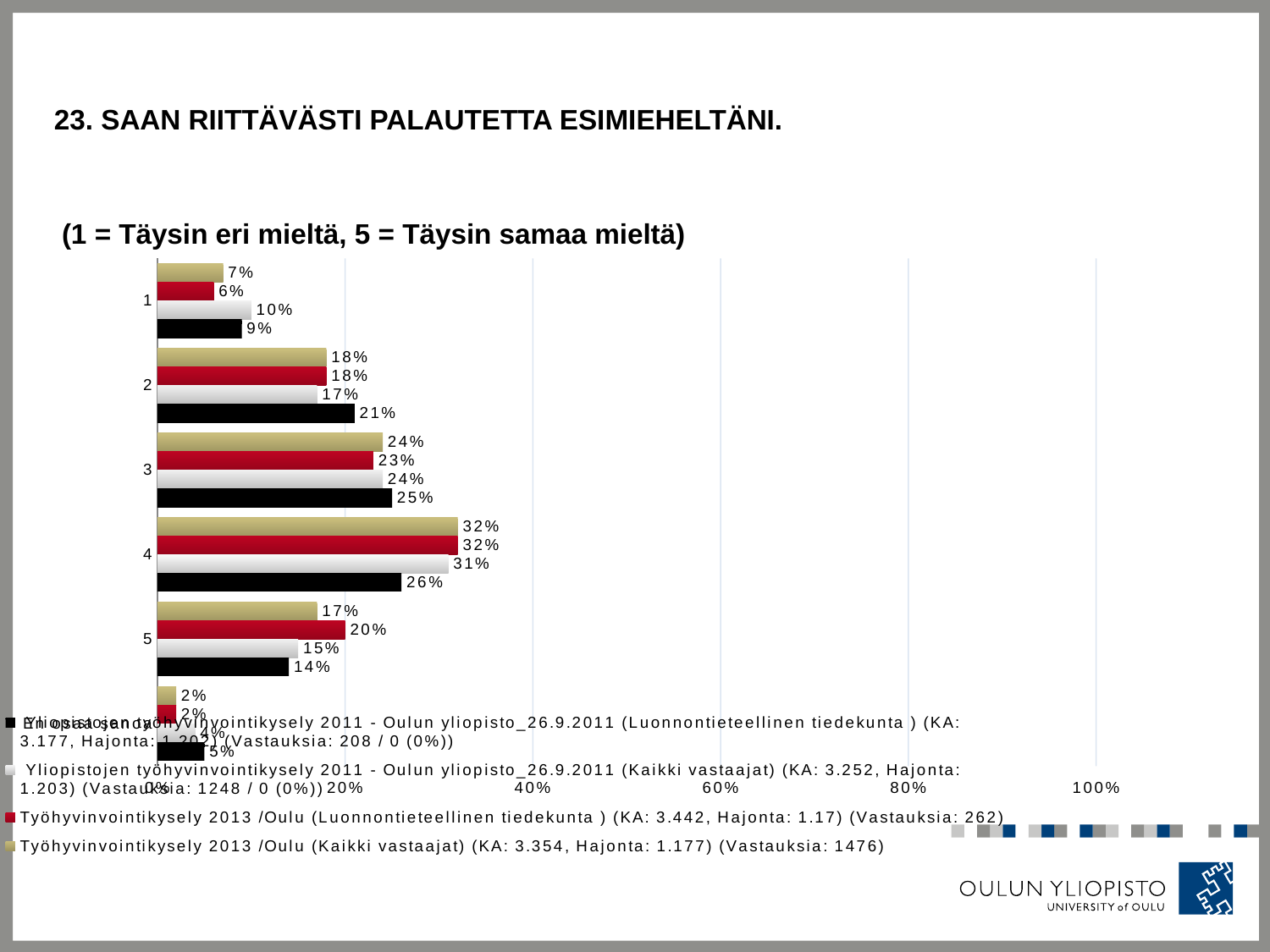
Which category has the highest value in the series Työhyvinvointikysely 2013 /Oulu (Kaikki vastaajat)? 4 What kind of chart is shown on the slide? Bar chart For category 5, which series has the larger value: Työhyvinvointikysely 2013 /Oulu (Luonnontieteellinen tiedekunta) or Yliopistojen työhyvinvointikysely 2011 - Oulun yliopisto (Luonnontieteellinen tiedekunta)? Työhyvinvointikysely 2013 /Oulu (Luonnontieteellinen tiedekunta) What is the value for category 5 in the series Työhyvinvointikysely 2013 /Oulu (Luonnontieteellinen tiedekunta)? 20% Which of categories 1 to 5 has the lowest value in the series Työhyvinvointikysely 2013 /Oulu (Luonnontieteellinen tiedekunta)? 1 What is the value for category 4 in the series Työhyvinvointikysely 2013 /Oulu (Kaikki vastaajat)? 32% What is the difference between the values for category 4 in the series Työhyvinvointikysely 2013 /Oulu (Kaikki vastaajat) and Yliopistojen työhyvinvointikysely 2011 - Oulun yliopisto (Luonnontieteellinen tiedekunta)? 6% What is the value for category 2 in the series Yliopistojen työhyvinvointikysely 2011 - Oulun yliopisto (Luonnontieteellinen tiedekunta)? 21% Is the value for category 3 in the series Yliopistojen työhyvinvointikysely 2011 - Oulun yliopisto (Luonnontieteellinen tiedekunta) greater or less than 40%? less How many series does the legend list? 4 What is the value for category 1 in the series Yliopistojen työhyvinvointikysely 2011 - Oulun yliopisto (Kaikki vastaajat)? 10% What is the title of the chart on the slide? 23. SAAN RIITTÄVÄSTI PALAUTETTA ESIMIEHELTÄNI.